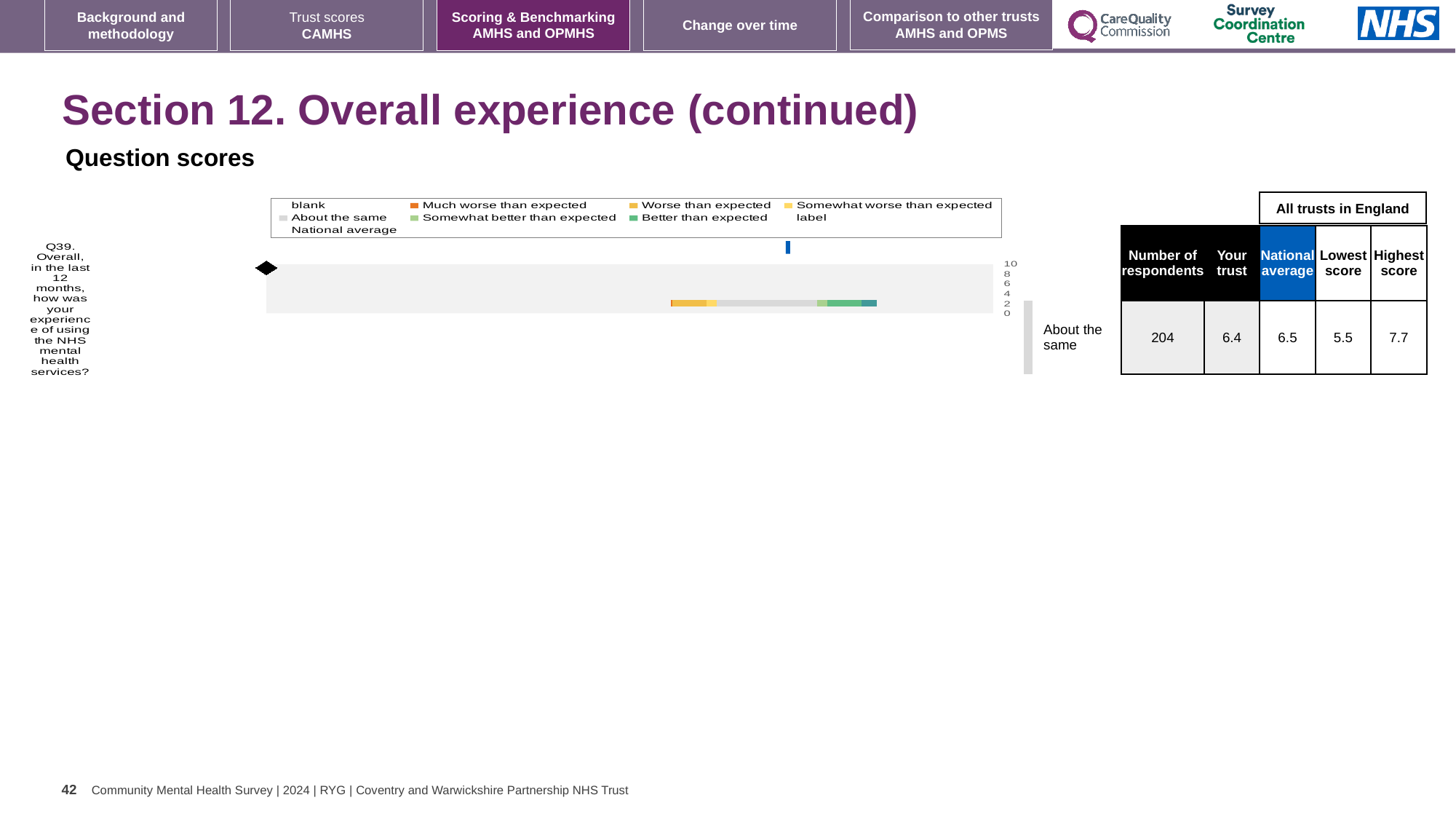
What kind of chart is shown on the slide? Bar chart How many entries does the chart legend list? 9 Which is larger for Q39, the 'Your trust' score or the national average? National average How many respondents answered Q39? 204 What benchmark category is shown for Q39 next to the chart? About the same What is the difference between the highest score and the lowest score for Q39? 2.2 What is the lowest score among all trusts in England for Q39? 5.5 What is the highest score among all trusts in England for Q39? 7.7 How many questions are plotted in the chart? 1 What is the 'Your trust' score for Q39? 6.4 Which question is plotted in the chart? Q39. Overall, in the last 12 months, how was your experience of using the NHS mental health services? What is the national average score for Q39? 6.5